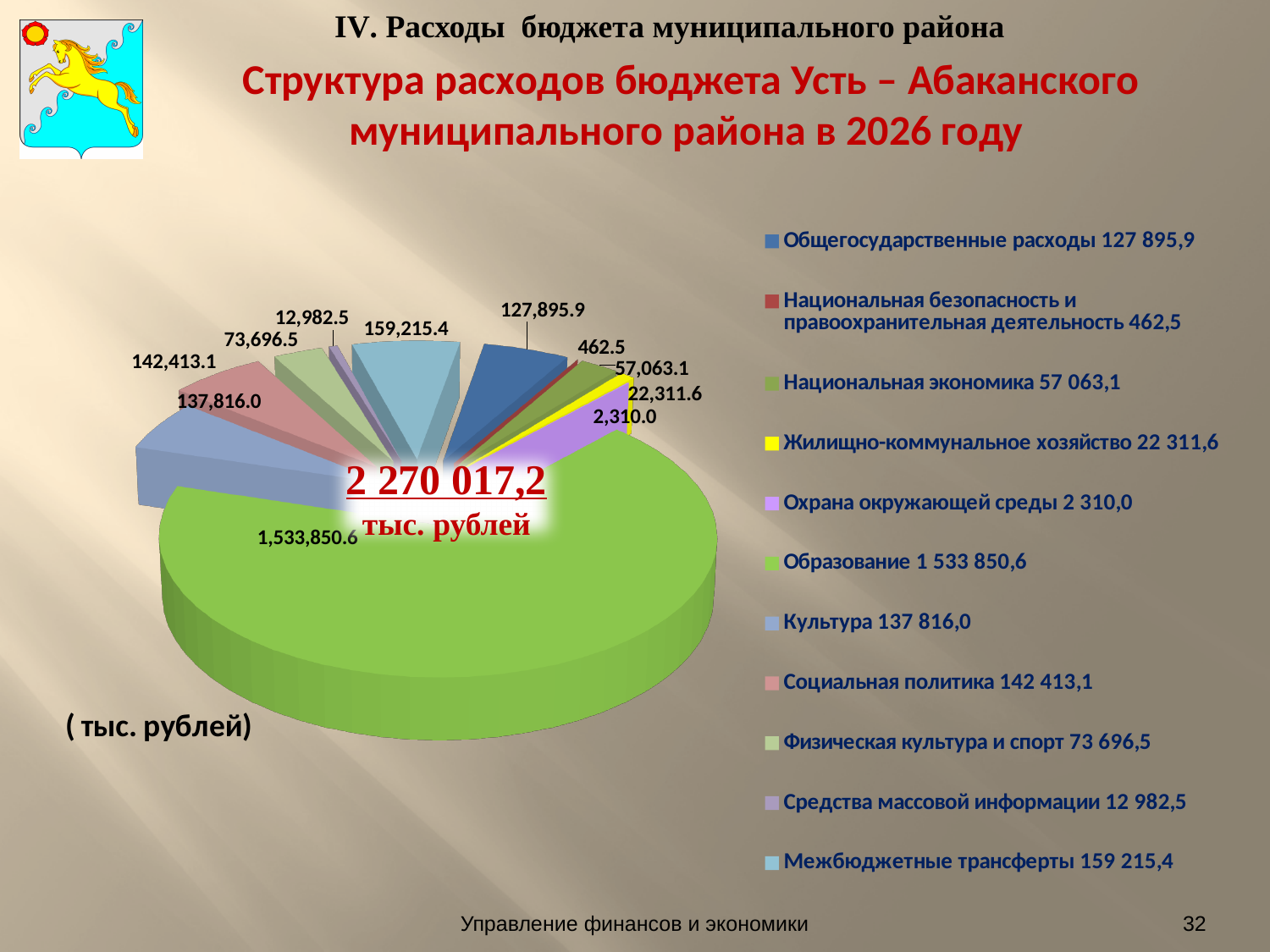
What is the value for Межбюджетные трансферты on the pie chart? 159,215.4 Which category has the smallest value on the pie chart? Национальная безопасность и правоохранительная деятельность Which category has the largest slice of the pie chart? Образование How many categories does the pie chart legend list? 11 What is the value for Образование on the pie chart? 1,533,850.6 What is the value for Жилищно-коммунальное хозяйство on the pie chart? 22,311.6 What total amount is printed in the centre of the pie chart? 2 270 017,2 тыс. рублей Which is larger: Межбюджетные трансферты or Социальная политика? Межбюджетные трансферты What type of chart is shown on the slide? Pie chart What is the value for Охрана окружающей среды on the pie chart? 2,310.0 What is the difference between the values for Социальная политика and Культура? 4,597.1 What colour is the Образование slice of the pie chart? Green